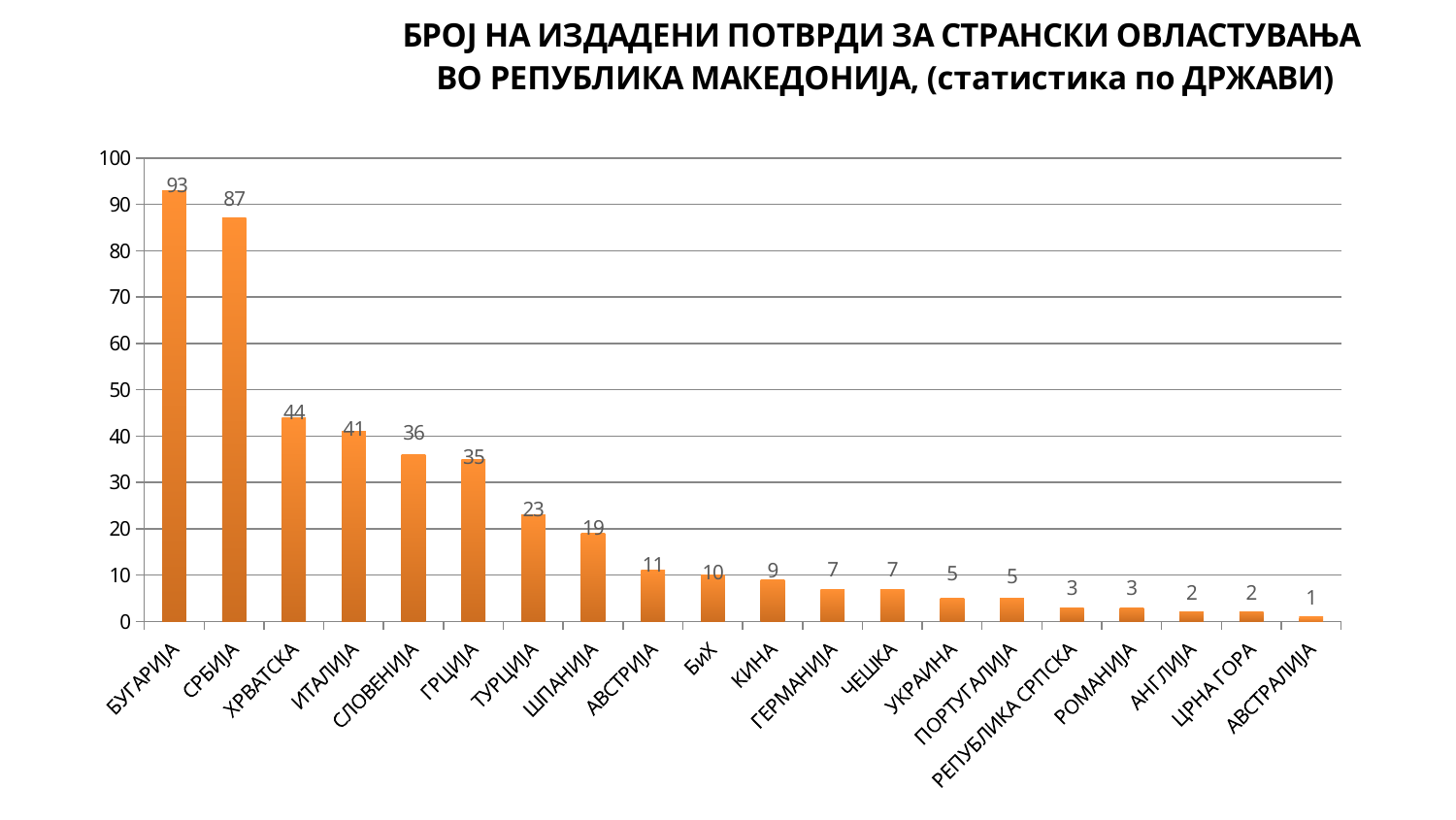
What kind of chart is shown on the slide? bar chart What is the value for ТУРЦИЈА? 23 Is the value for ШПАНИЈА greater or less than 30? less Do the values rise or fall from left to right along the x axis? fall What is the difference between the values for ХРВАТСКА and ГРЦИЈА? 9 Which country has the lowest value? АВСТРАЛИЈА What is the difference between the values for БУГАРИЈА and СРБИЈА? 6 Which country has the highest value? БУГАРИЈА What is the value for СРБИЈА? 87 What is the value for КИНА? 9 How many countries are shown on the chart? 20 Which is larger, the value for ИТАЛИЈА or the value for СЛОВЕНИЈА? ИТАЛИЈА